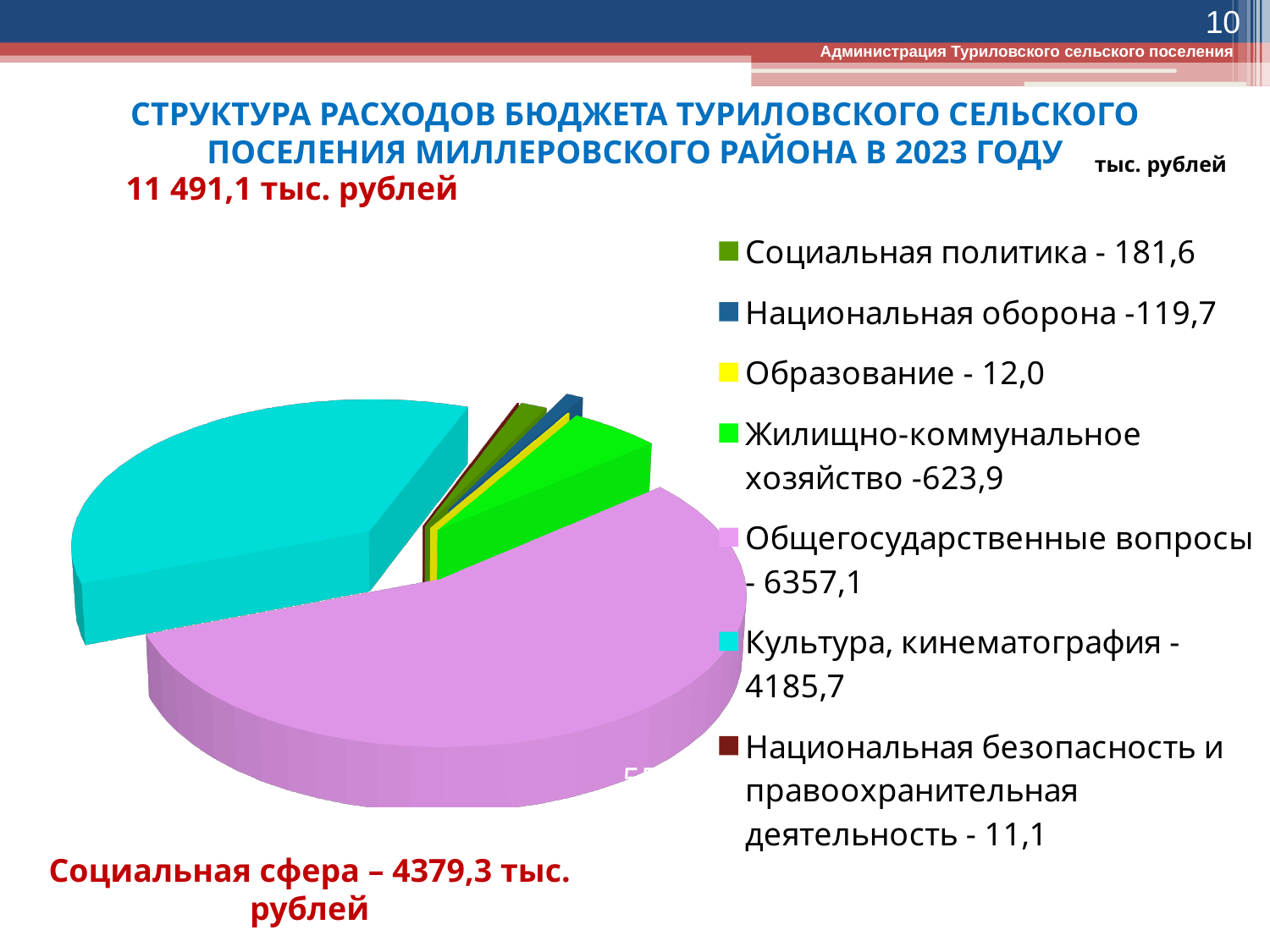
What is the difference between the values for Общегосударственные вопросы and Культура, кинематография? 2171,4 What colour is the slice for Культура, кинематография? cyan What is the value for Общегосударственные вопросы? 6357,1 What is the value for Национальная оборона? 119,7 Which category has the smallest value in the legend? Национальная безопасность и правоохранительная деятельность What kind of chart is shown on the slide? pie chart What is the value for Культура, кинематография? 4185,7 Which is larger: Жилищно-коммунальное хозяйство or Социальная политика? Жилищно-коммунальное хозяйство What is the value for Жилищно-коммунальное хозяйство? 623,9 How many categories does the legend of the pie chart list? 7 What total amount of budget expenditures is stated on the slide? 11 491,1 тыс. рублей Which category has the largest share of the pie? Общегосударственные вопросы